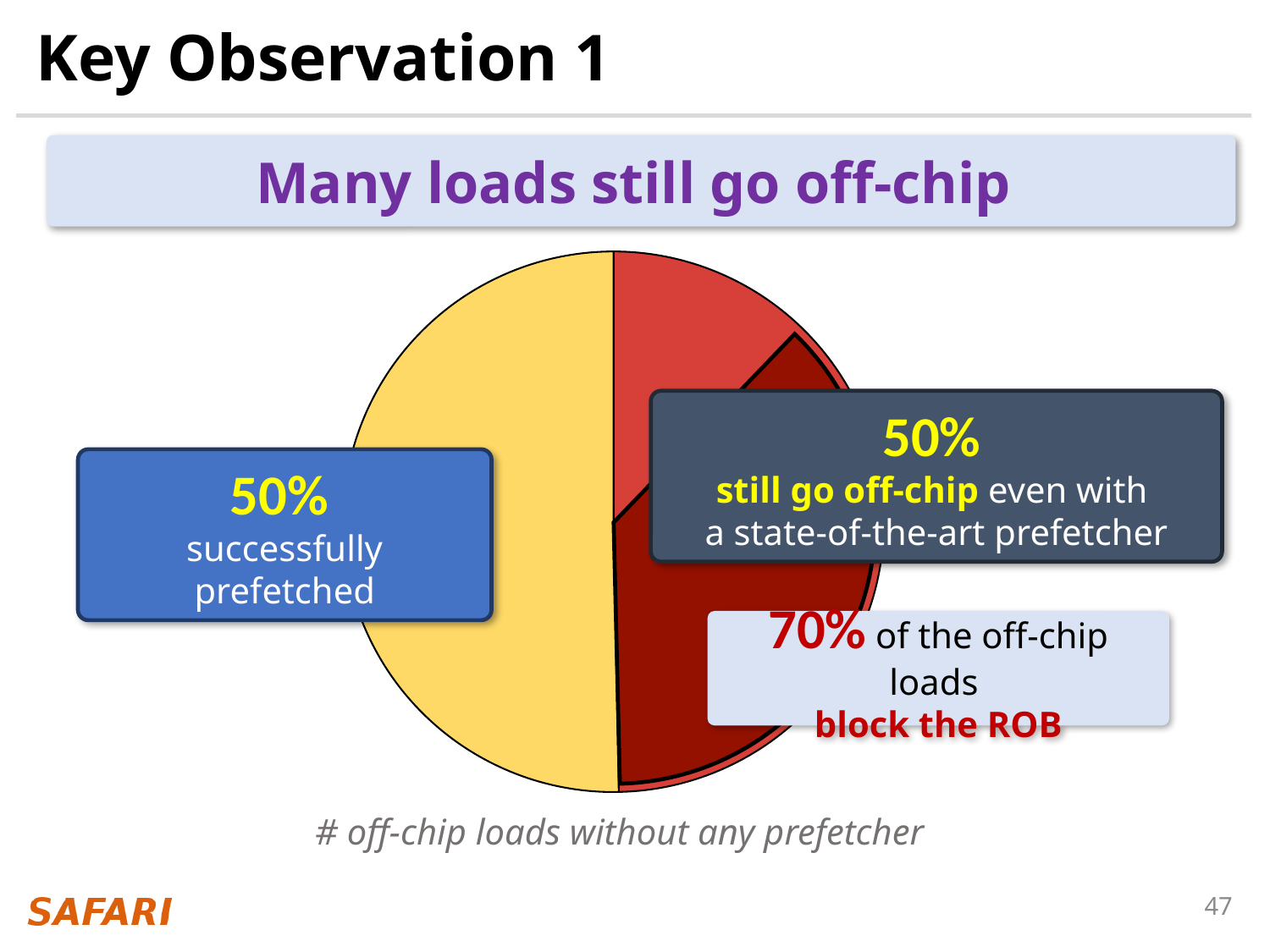
What share of off-chip loads is successfully prefetched according to the pie chart? 50% What is the caption below the pie chart? # off-chip loads without any prefetcher Is the share of loads that still go off-chip larger or smaller than the share successfully prefetched? equal Which colour represents the loads that are successfully prefetched? yellow What is the difference between the share successfully prefetched and the share that still go off-chip? 0% What kind of chart is shown on the slide? pie chart What percentage of the off-chip loads block the ROB? 70% Is the share of off-chip loads that block the ROB greater or less than 50%? greater What share of loads still go off-chip even with a state-of-the-art prefetcher? 50% What is the combined share of the successfully prefetched and still-go-off-chip portions of the pie? 100%